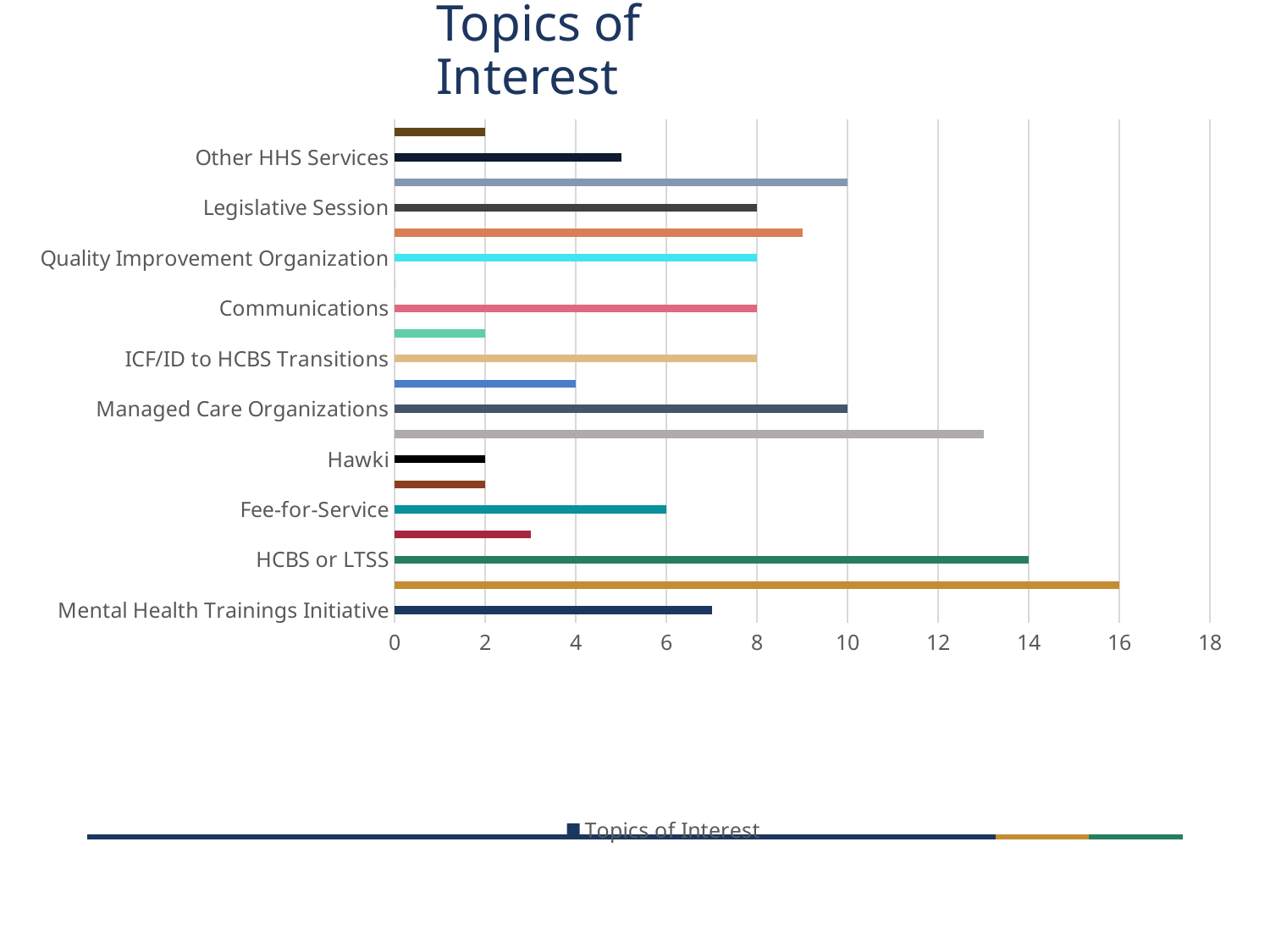
What type of chart is shown on the slide? bar chart What is the value for Managed Care Organizations? 10 How many series does the legend list? 1 What is the value for Fee-for-Service? 6 What is the difference between the values for HCBS or LTSS and Managed Care Organizations? 4 Is the value for Mental Health Trainings Initiative greater or less than 6? greater Which is larger, the value for HCBS or LTSS or the value for Fee-for-Service? HCBS or LTSS What is the title of the chart? Topics of Interest What is the value for Hawki? 2 Is the value for Other HHS Services greater or less than 4? greater What is the value for HCBS or LTSS? 14 What is the value for Legislative Session? 8